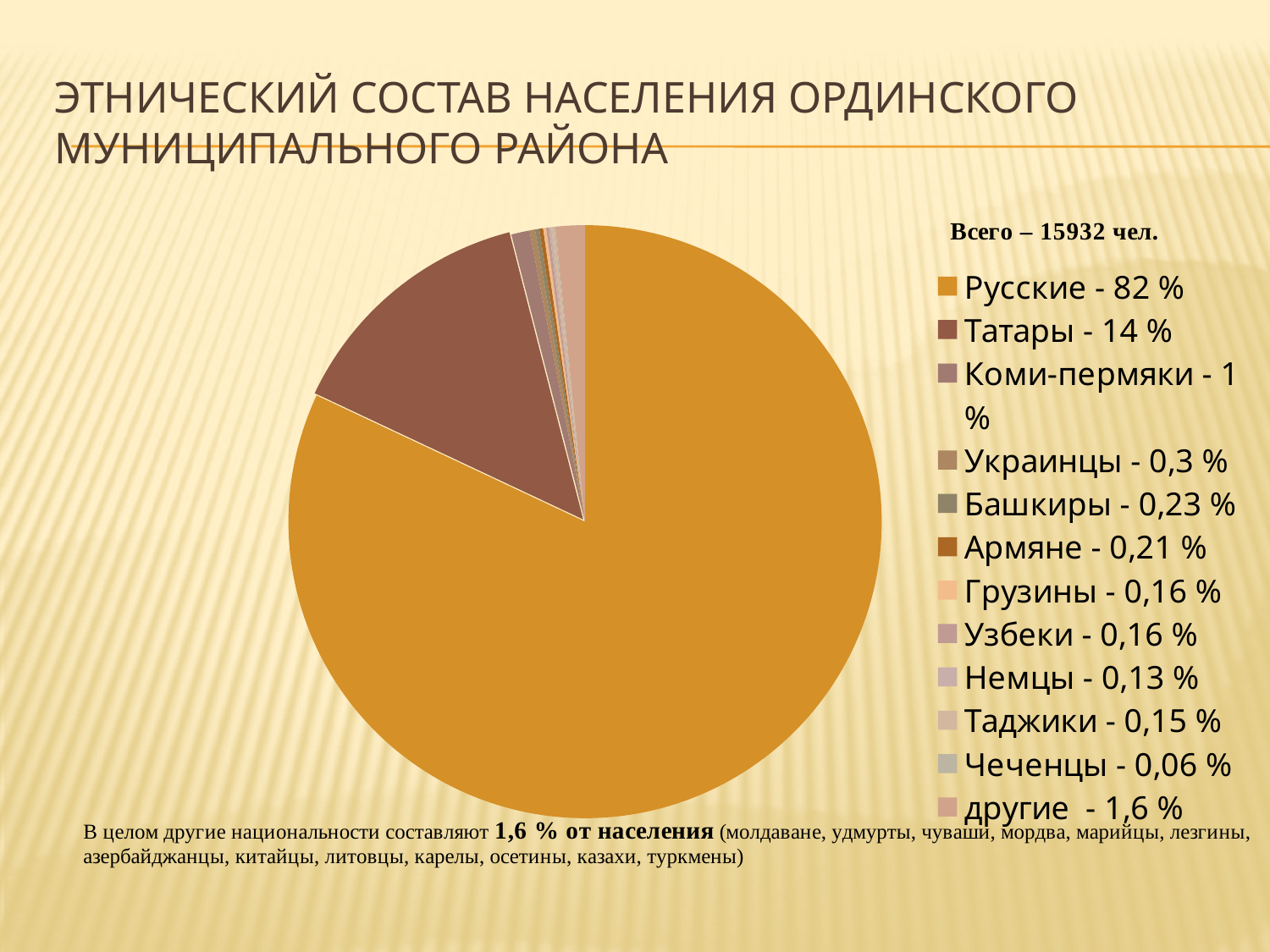
What kind of chart is shown on the slide? pie chart Which ethnic group listed in the legend has the smallest share? Чеченцы What share is given for the category 'другие' (others)? 1,6 % Which group has a larger share, Башкиры or Армяне? Башкиры What value is given for Чеченцы (Chechens) in the legend? 0,06 % What share of the population do Русские (Russians) make up according to the legend? 82 % How many entries does the legend of the pie chart list? 12 What total population figure is stated above the legend? 15932 чел. Which ethnic group has the largest slice of the pie? Русские What is the difference in percentage points between the shares of Русские and Татары? 68 % What value is given for Украинцы (Ukrainians) in the legend? 0,3 % What share of the population do Татары (Tatars) make up? 14 %